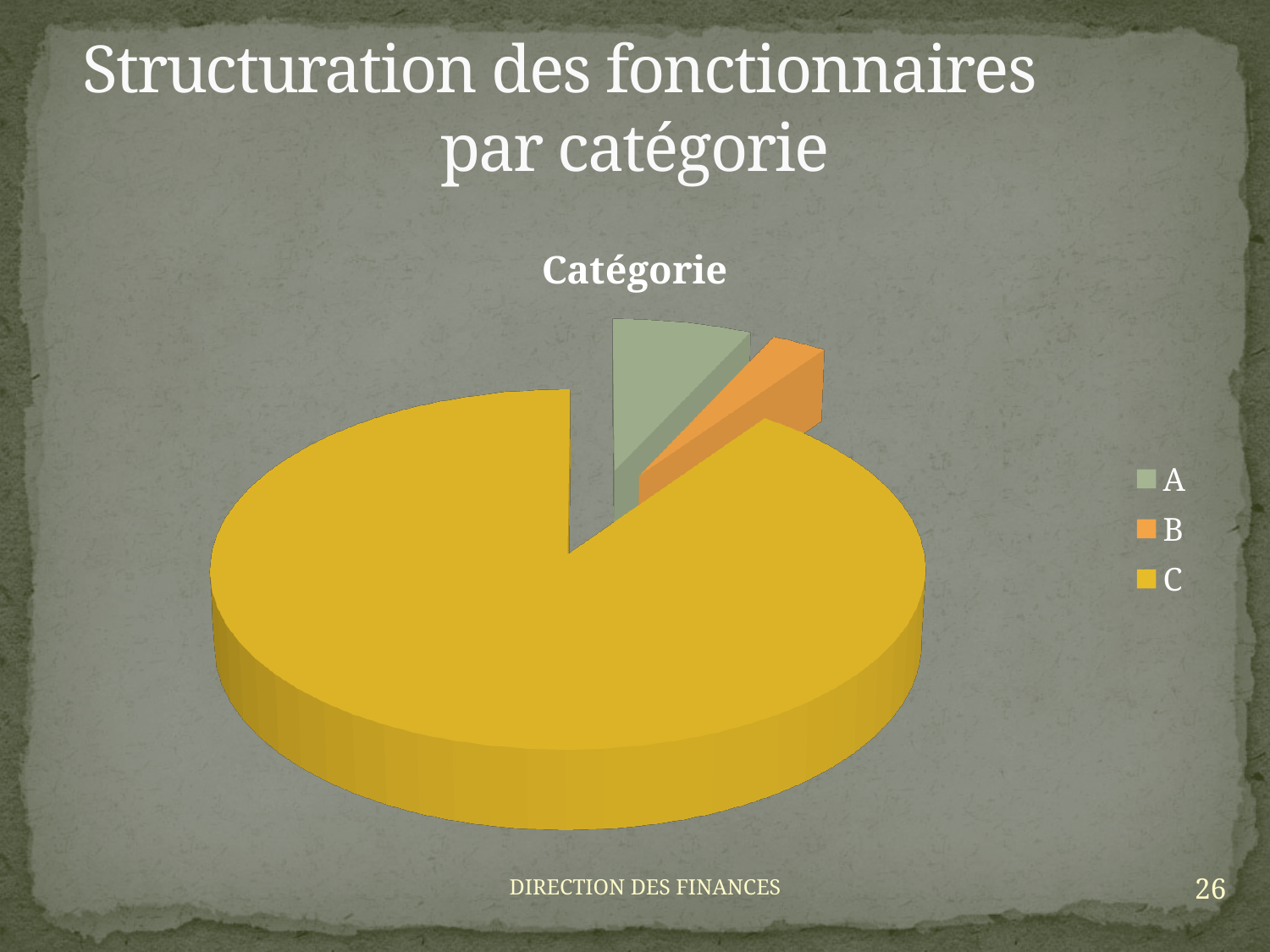
Does category C account for more or less than half of the pie? more Which slice is larger, A or B? A Which colour represents category C in the pie chart? yellow How many slices does the pie chart have? 3 Which slice is larger, C or A? C Which category has the largest slice of the pie? C Which category has the smallest slice of the pie? B How many entries does the legend list? 3 What is the title of the chart? Catégorie What kind of chart is shown on the slide? pie chart